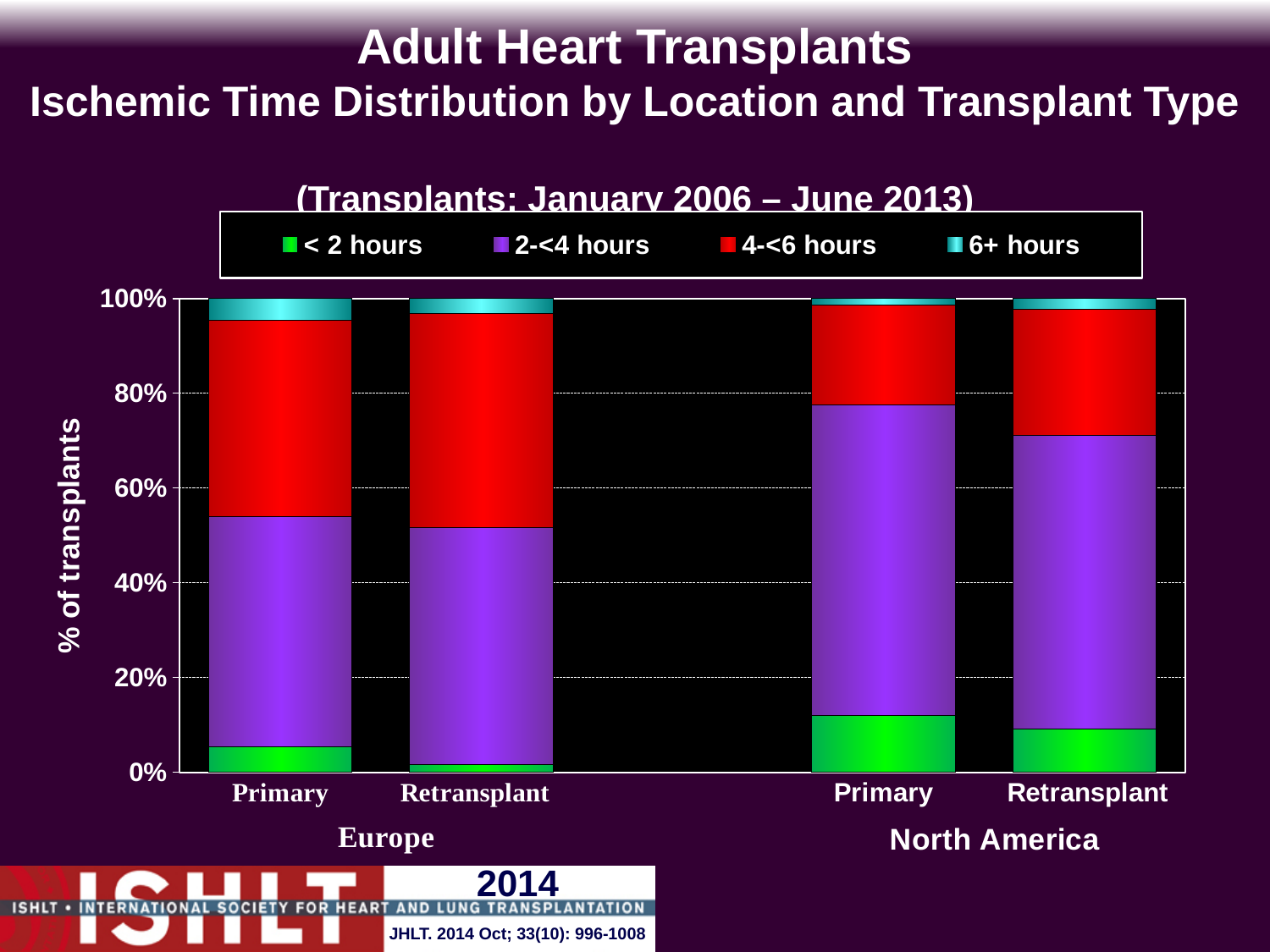
What does each stacked bar total on the y axis? 100% Is the cumulative share of transplants with ischemic time under 4 hours for North America Primary greater or less than 60%? greater How many bars are plotted in the chart? 4 Which ischemic time category is shown in red in the legend? 4-<6 hours Which Primary bar has the larger < 2 hours segment, Europe or North America? North America What is the label of the y axis? % of transplants Which bar has the largest 2-<4 hours segment? North America Primary How many series does the legend list? 4 Is the cumulative share of transplants with ischemic time under 4 hours for Europe Primary greater or less than 60%? less Which Primary bar has the larger 4-<6 hours segment, Europe or North America? Europe What kind of chart is shown on the slide? Stacked bar chart Is the < 2 hours share for North America Primary greater or less than 20%? less